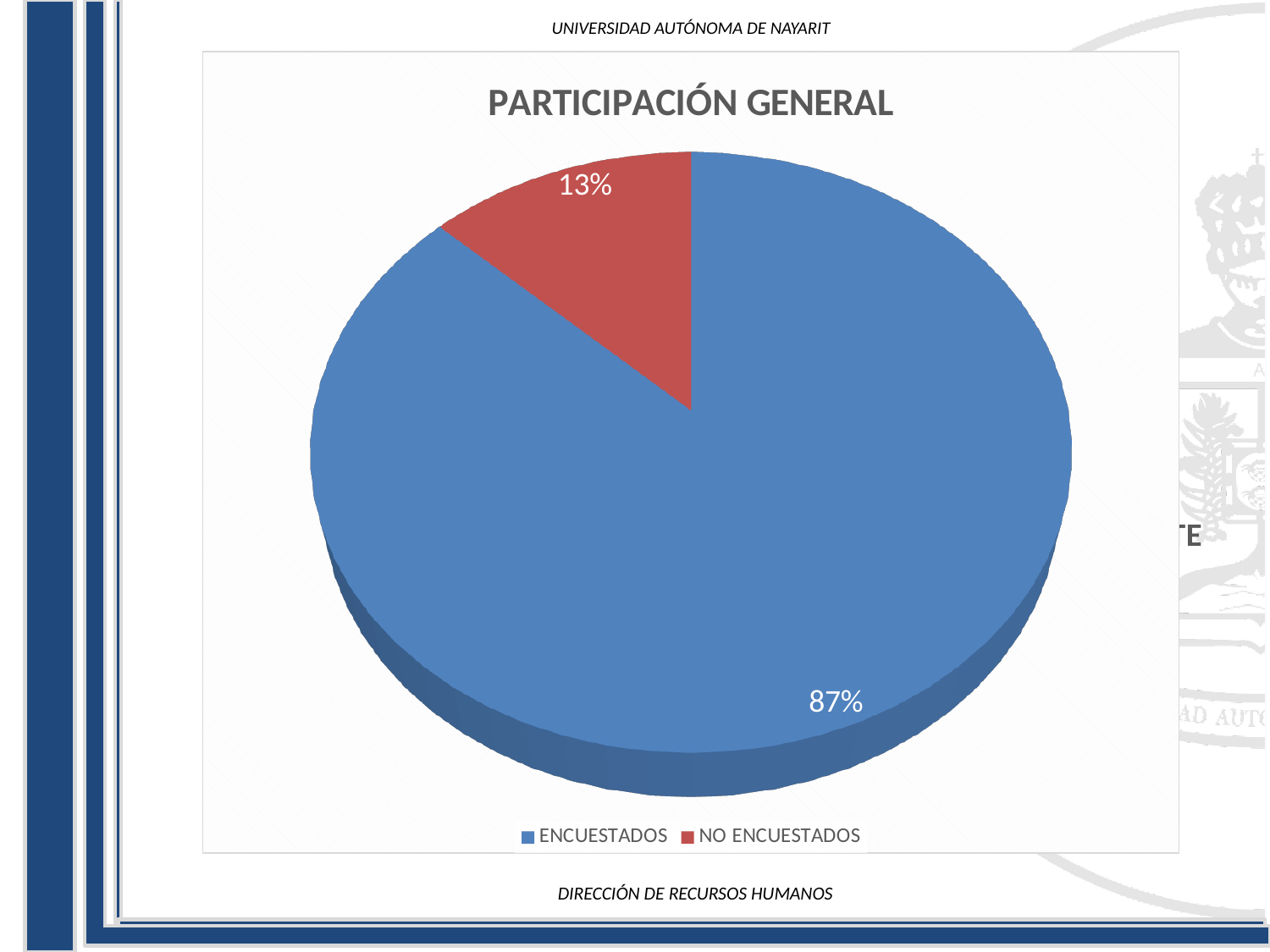
How many slices does the pie chart have? 2 Which is larger, the share for ENCUESTADOS or for NO ENCUESTADOS? ENCUESTADOS What share of the pie does the ENCUESTADOS slice represent? 87% What percentage is shown for NO ENCUESTADOS? 13% What kind of chart is shown on the slide? Pie chart What is the difference in percentage points between ENCUESTADOS and NO ENCUESTADOS? 74 How many entries does the legend list? 2 What is the title of the chart? PARTICIPACIÓN GENERAL Which category has the smallest share of the pie? NO ENCUESTADOS What colour is the slice for NO ENCUESTADOS? Red What percentage is shown for ENCUESTADOS? 87% Which category has the largest share of the pie? ENCUESTADOS